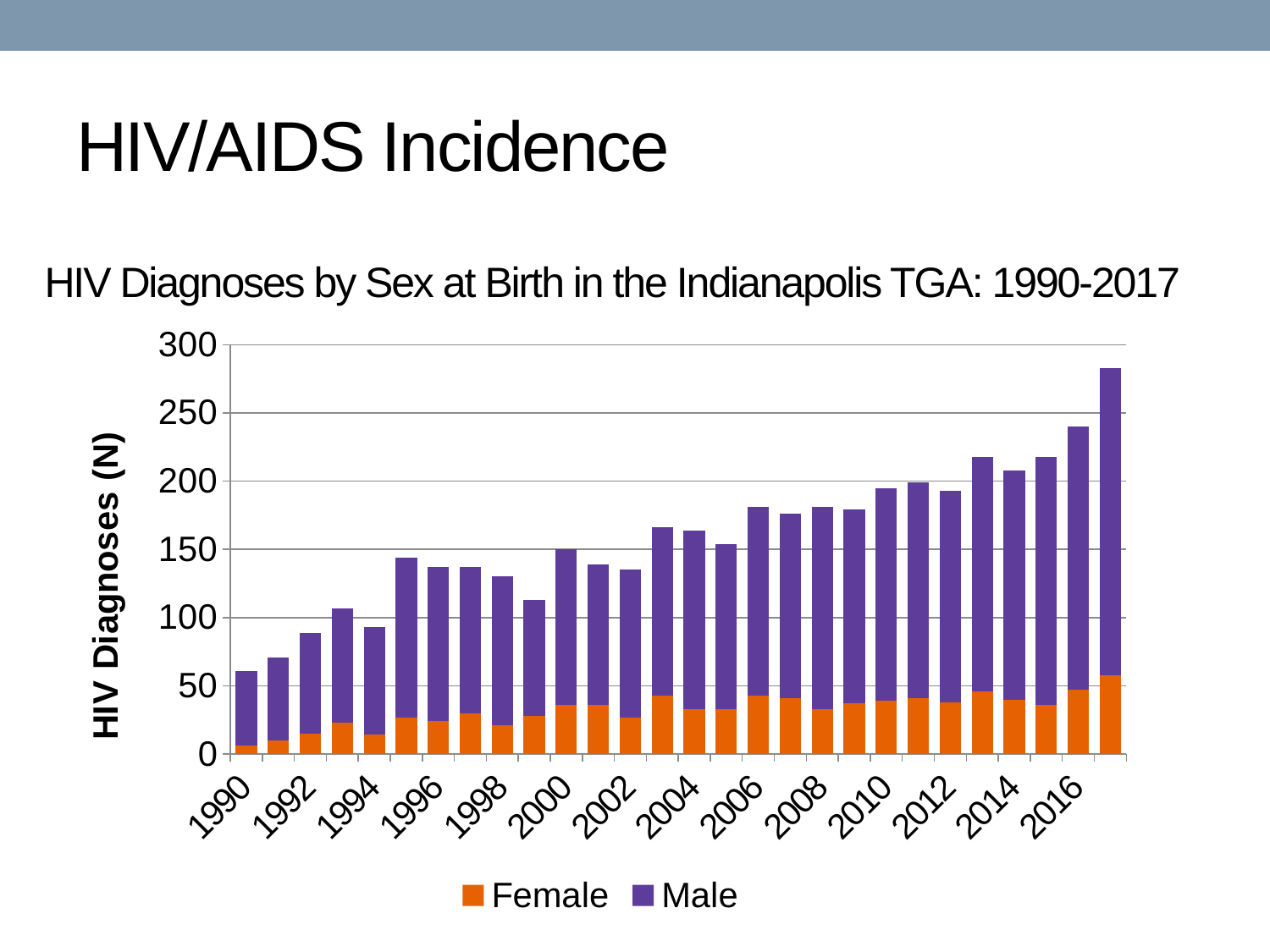
How many years (bars) are plotted in the chart? 28 Which year has the highest total number of HIV diagnoses? 2017 What kind of chart is shown on the slide? Stacked bar chart Is the total number of HIV diagnoses in 2013 greater or less than 200? greater Is the total number of HIV diagnoses in 1999 greater or less than 150? less Overall, do total HIV diagnoses rise or fall from 1990 to 2017? Rise Which year has the lowest total number of HIV diagnoses? 1990 What is the label on the vertical axis? HIV Diagnoses (N) Which two series are shown in the legend? Female and Male Is the total number of HIV diagnoses in 2017 greater or less than 250? greater How many series does the legend list? 2 Which year has a larger total of HIV diagnoses, 1993 or 1994? 1993